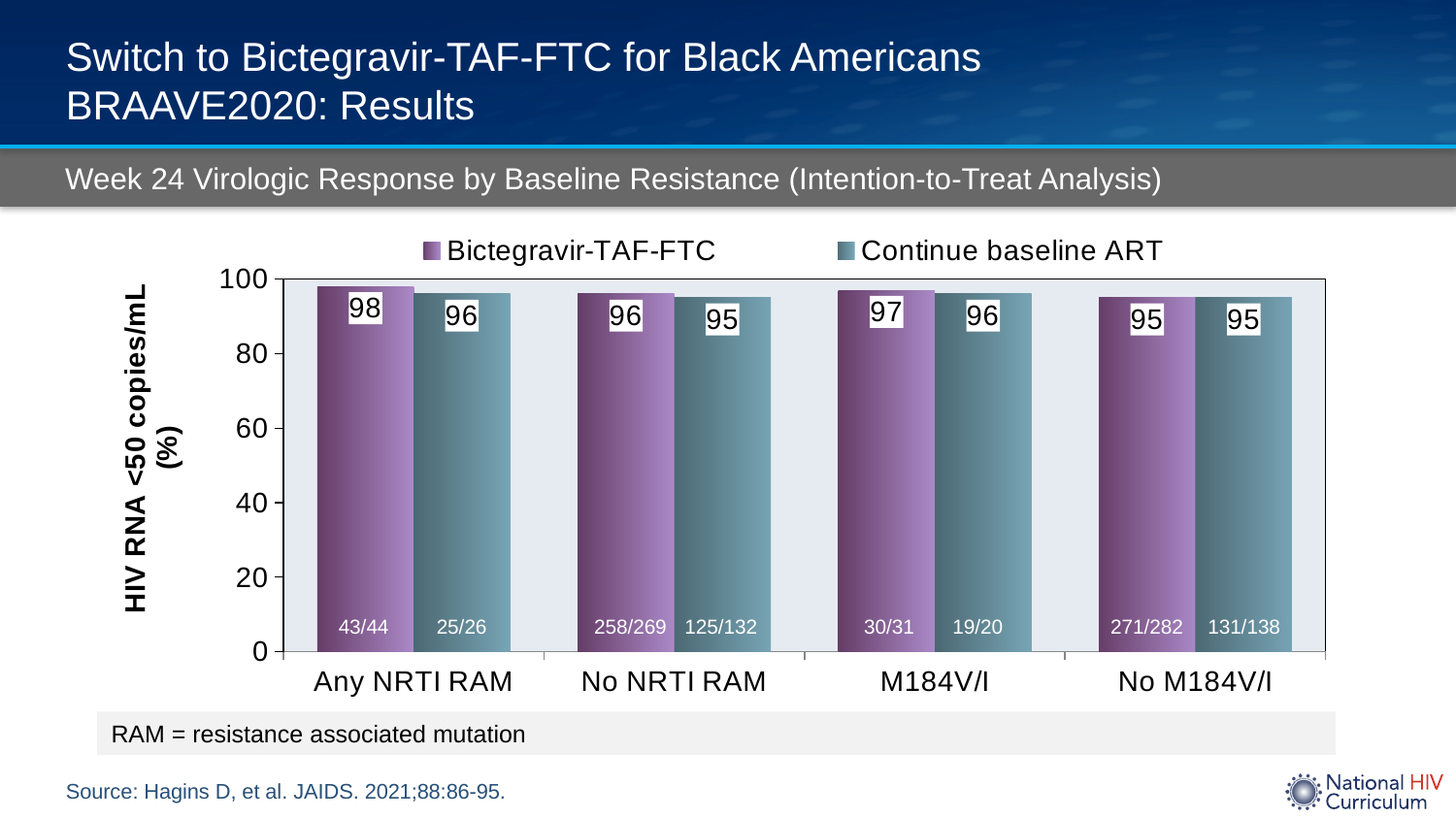
What kind of chart is shown on the slide? Bar chart Which category has the highest value for Bictegravir-TAF-FTC? Any NRTI RAM What is the value for Bictegravir-TAF-FTC in the Any NRTI RAM category? 98 What is the label of the y axis? HIV RNA <50 copies/mL (%) What is the value for Continue baseline ART in the No NRTI RAM category? 95 How many categories are shown on the x axis? 4 What is the value for Bictegravir-TAF-FTC in the M184V/I category? 97 What is the value for Continue baseline ART in the No M184V/I category? 95 What is the difference between the Bictegravir-TAF-FTC and Continue baseline ART values in the Any NRTI RAM category? 2 In the No NRTI RAM category, which series has the larger value, Bictegravir-TAF-FTC or Continue baseline ART? Bictegravir-TAF-FTC How many series does the legend list? 2 Which category has the lowest value for Bictegravir-TAF-FTC? No M184V/I